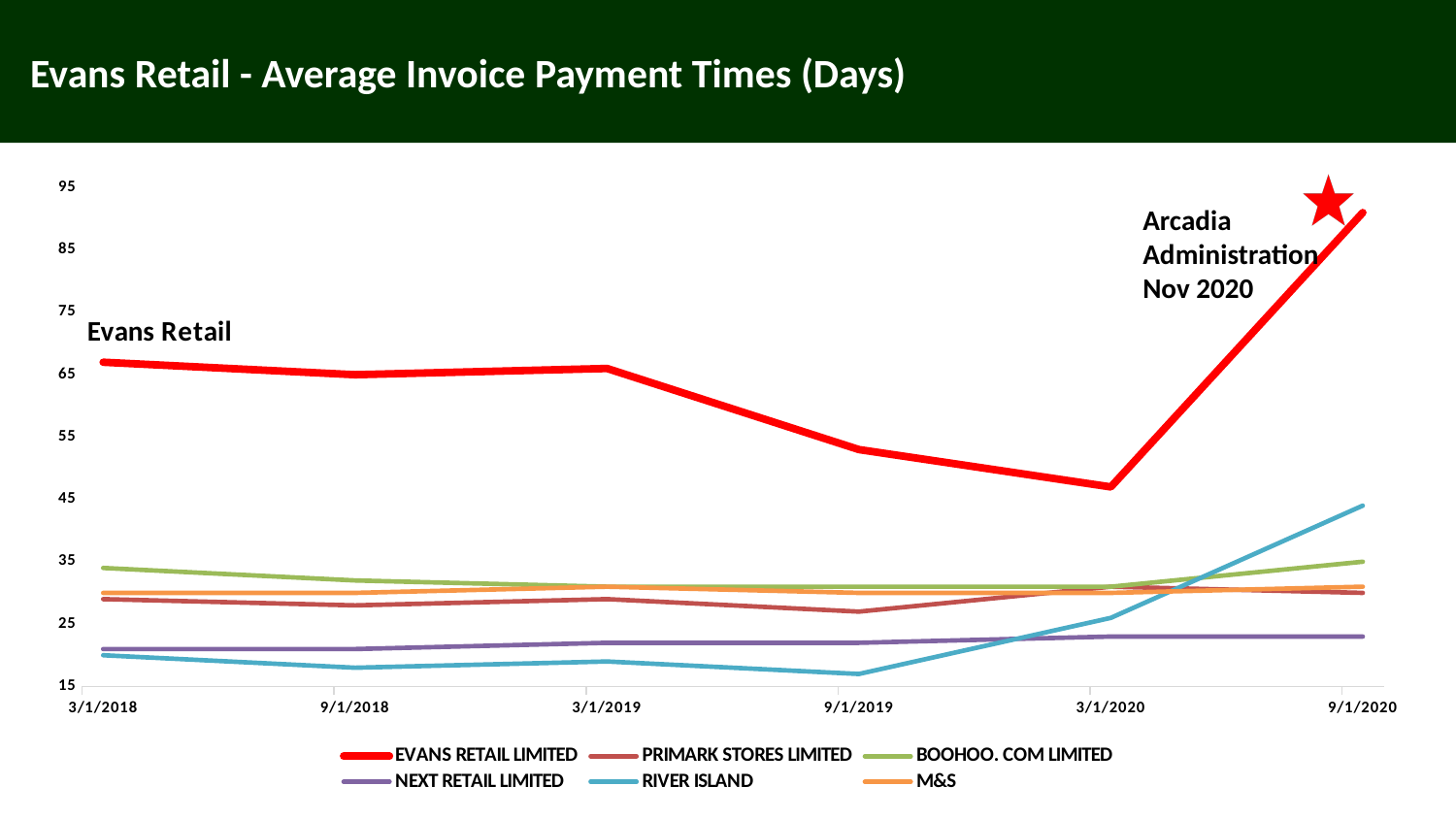
Does the EVANS RETAIL LIMITED line rise or fall between 3/1/2019 and 3/1/2020? fall At 9/1/2020, which is higher: RIVER ISLAND or NEXT RETAIL LIMITED? RIVER ISLAND What kind of chart is shown on the slide? line chart What event does the annotation next to the star mark? Arcadia Administration Nov 2020 How many series does the legend list? 6 Is the value for EVANS RETAIL LIMITED at 3/1/2020 greater or less than 55? less Which series has the lowest value at 9/1/2019? RIVER ISLAND Which series has the highest value at 3/1/2018? EVANS RETAIL LIMITED Is the value for EVANS RETAIL LIMITED at 9/1/2020 greater or less than 85? greater At 3/1/2018, which is higher: BOOHOO. COM LIMITED or PRIMARK STORES LIMITED? BOOHOO. COM LIMITED Is the value for RIVER ISLAND at 9/1/2020 greater or less than 35? greater How many dates are labelled on the x axis? 6